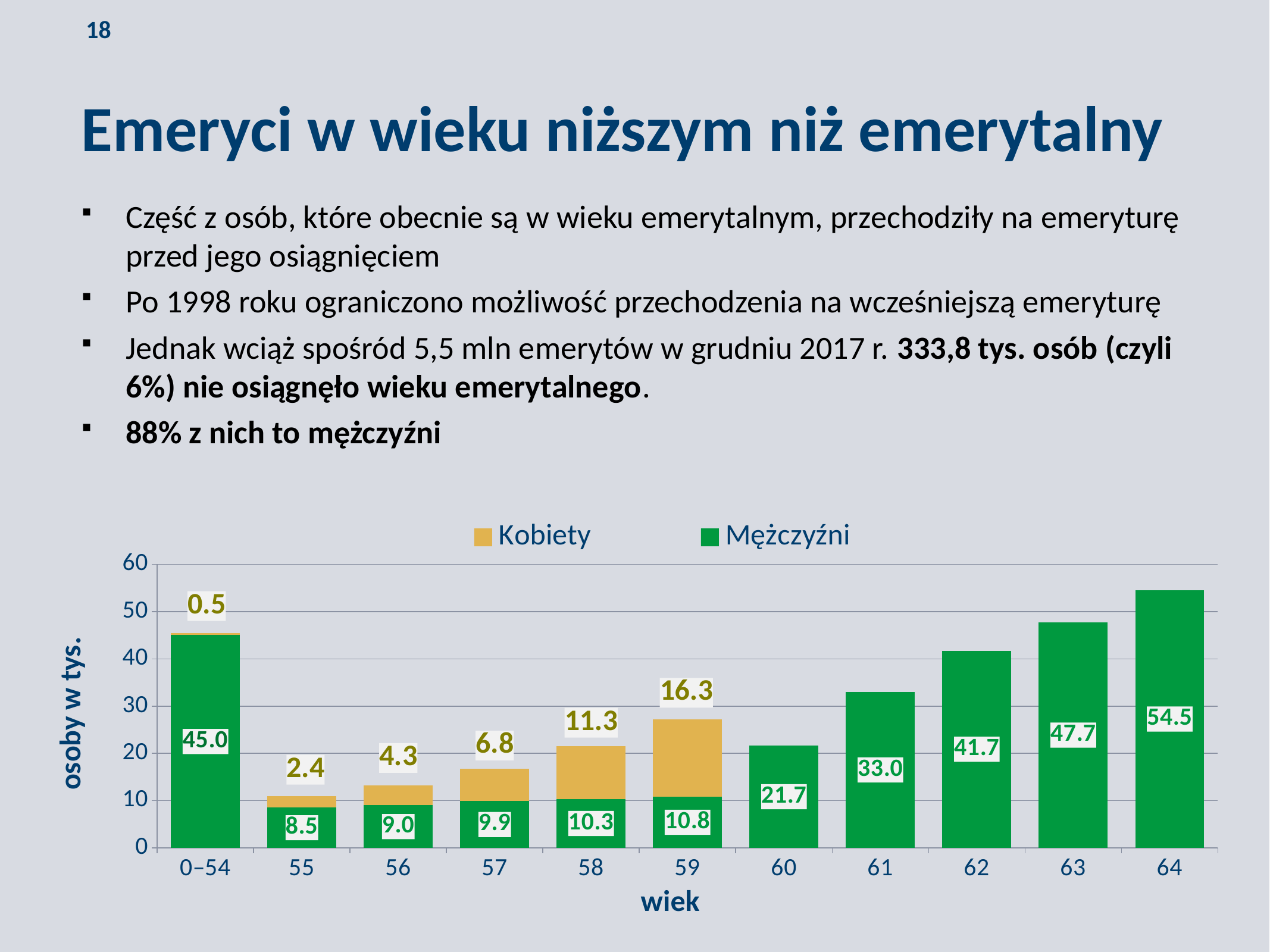
Which age category has the highest value for Mężczyźni? 64 How many series does the legend list? 2 What is the value for Kobiety at age 58? 11.3 What is the value for Mężczyźni at age 64? 54.5 Which age category has the lowest value for Mężczyźni? 55 Do the Mężczyźni values rise or fall from age 55 to age 64? Rise What is the total of the stacked bar for age 59? 27.1 What is the difference between the Mężczyźni values for age 64 and age 0–54? 9.5 How many age categories are shown on the x axis? 11 At age 59, which series has the larger value, Kobiety or Mężczyźni? Kobiety Which age category has the highest value for Kobiety? 59 What kind of chart is shown on the slide? Stacked bar chart